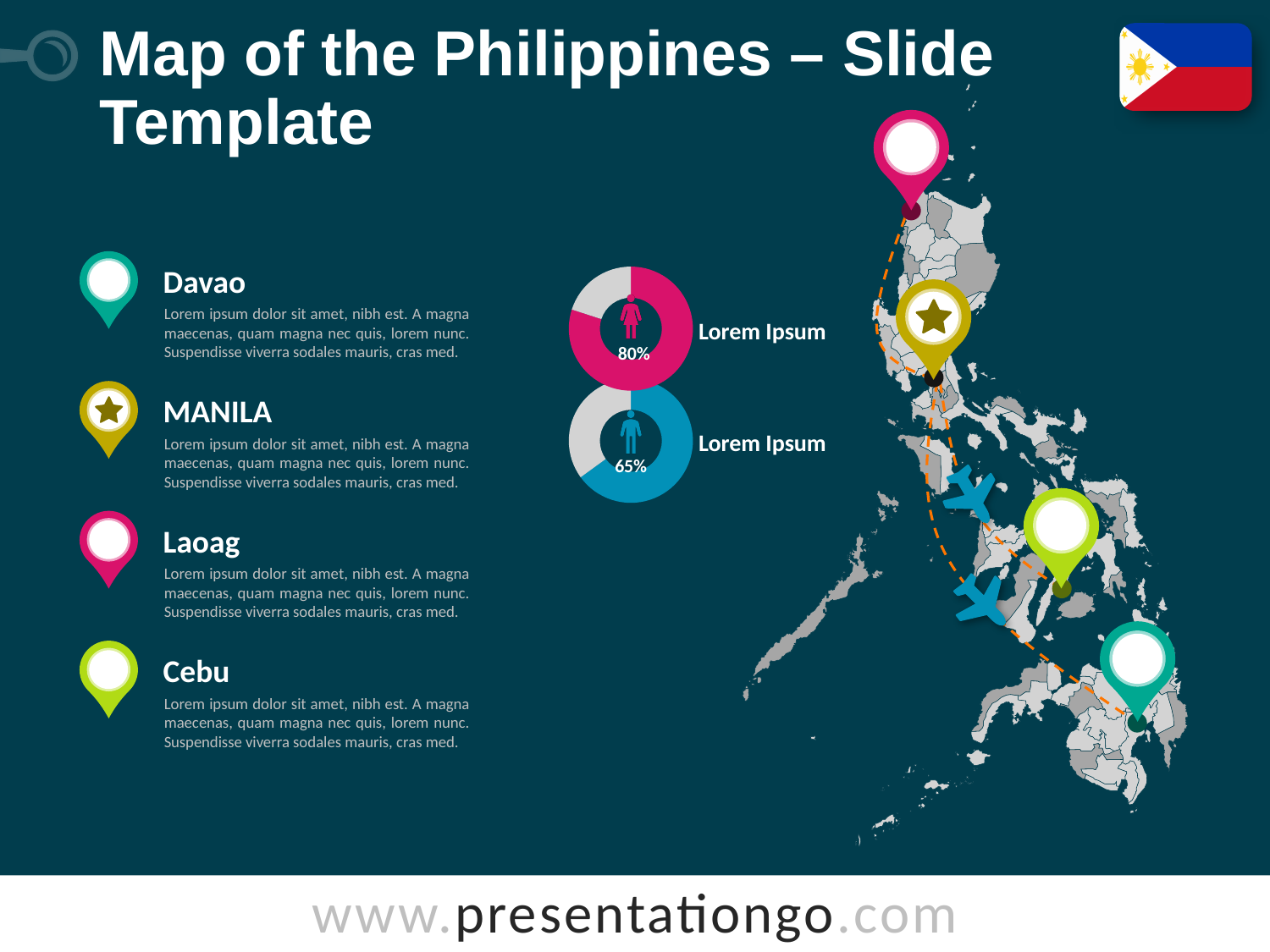
What value is shown on the upper (pink) donut chart? 80% What icon is shown in the centre of the upper (pink) donut chart? A female figure Is the value on the upper (pink) donut chart greater or less than 75%? greater How many donut charts are on the slide? 2 Which donut chart shows the higher value, the upper pink one or the lower blue one? The upper pink one What label appears to the right of each donut chart? Lorem Ipsum What is the difference between the values shown on the upper and lower donut charts? 15% Is the value on the lower (blue) donut chart greater or less than 70%? less What kind of charts are shown in the middle of the slide? Donut charts What value is shown on the lower (blue) donut chart? 65%